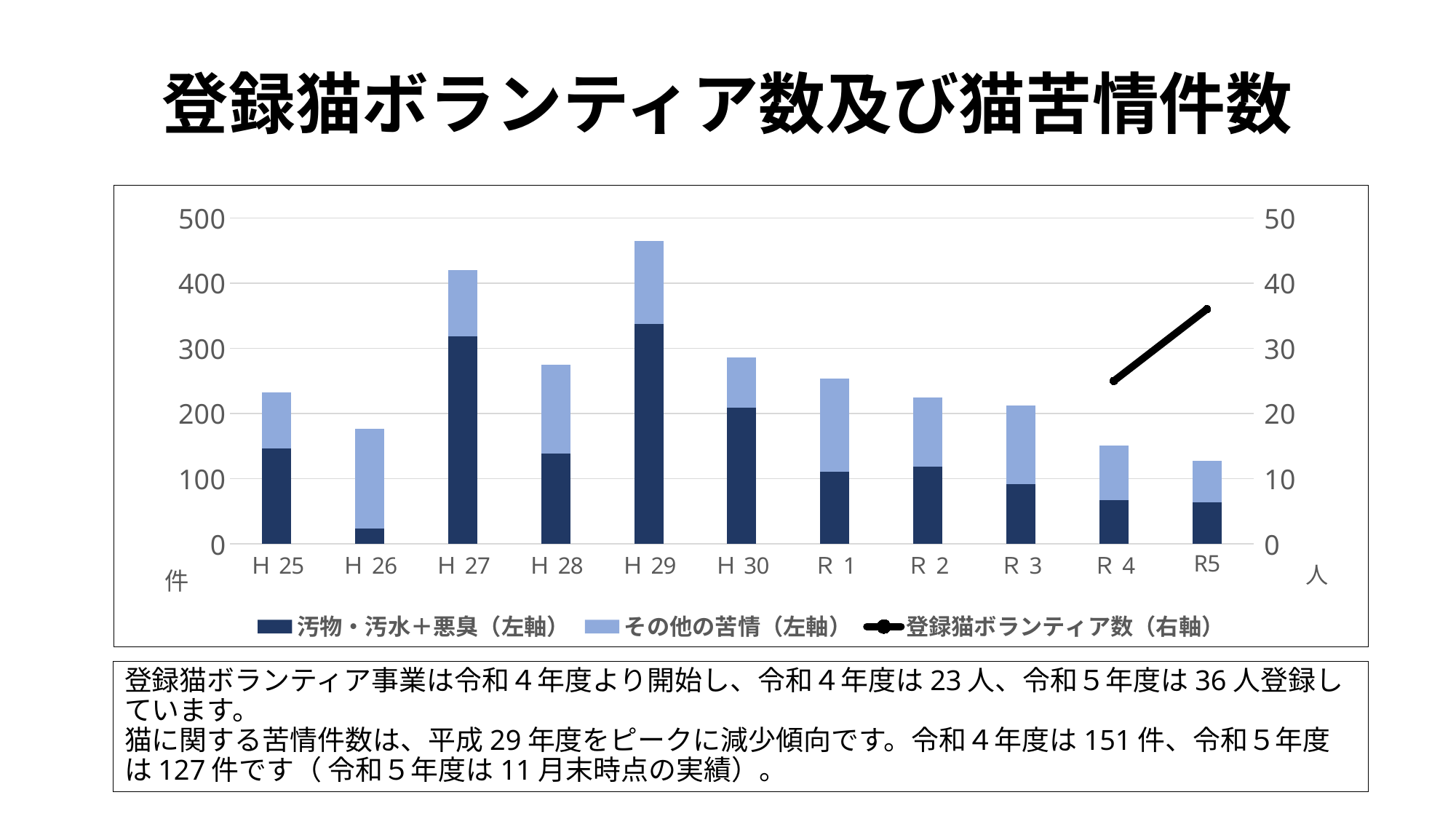
What kind of chart is shown on the slide? A stacked bar chart combined with a line chart Is the total complaint count for H26 greater or less than 200? less Is the total complaint count for H27 greater or less than 400? greater What is the title of the chart on the slide? 登録猫ボランティア数及び猫苦情件数 Which has the larger total complaint count, H27 or H28? H27 How many fiscal-year categories are shown on the x axis? 11 According to the slide, what is the difference between the cat complaint counts for R4 (151件) and R5 (127件)? 24件 According to the slide, how many registered cat volunteers were there in R5 (令和5年度)? 36人 Is the 汚物・汚水＋悪臭 value for H29 greater or less than 300? greater How many series does the chart legend list? 3 Which fiscal year has the highest total number of cat complaints (tallest stacked bar)? H29 Which fiscal year has the lowest total number of cat complaints (shortest stacked bar)? R5